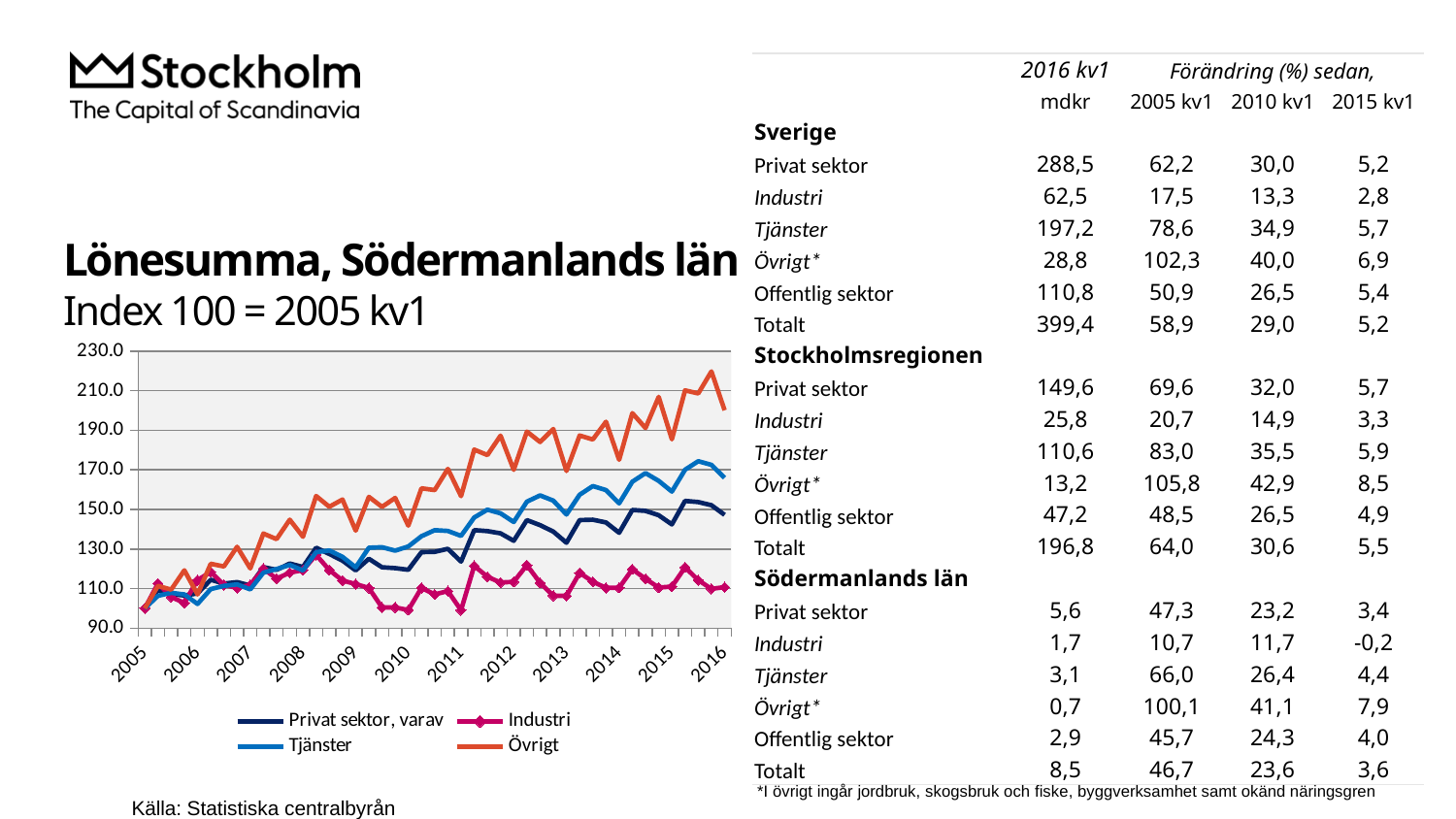
How many series does the chart legend list? 4 What kind of chart is shown on the slide? Line chart How many year labels are shown on the x axis of the chart? 12 Which series has the lowest value at the end of the chart in 2016? Industri Is the value for Övrigt at the end of 2016 greater or less than 190? greater Which series has the highest value at the end of the chart in 2016? Övrigt Is the value for Industri at the end of 2016 greater or less than 130? less What base period is the index set to 100 in the chart? 2005 kv1 At the end of 2016, which is larger: Tjänster or Privat sektor, varav? Tjänster Is the value for Tjänster at the end of 2016 greater or less than 150? greater What is the title of the chart? Lönesumma, Södermanlands län Does the Övrigt series generally rise or fall from 2005 to 2016? Rise